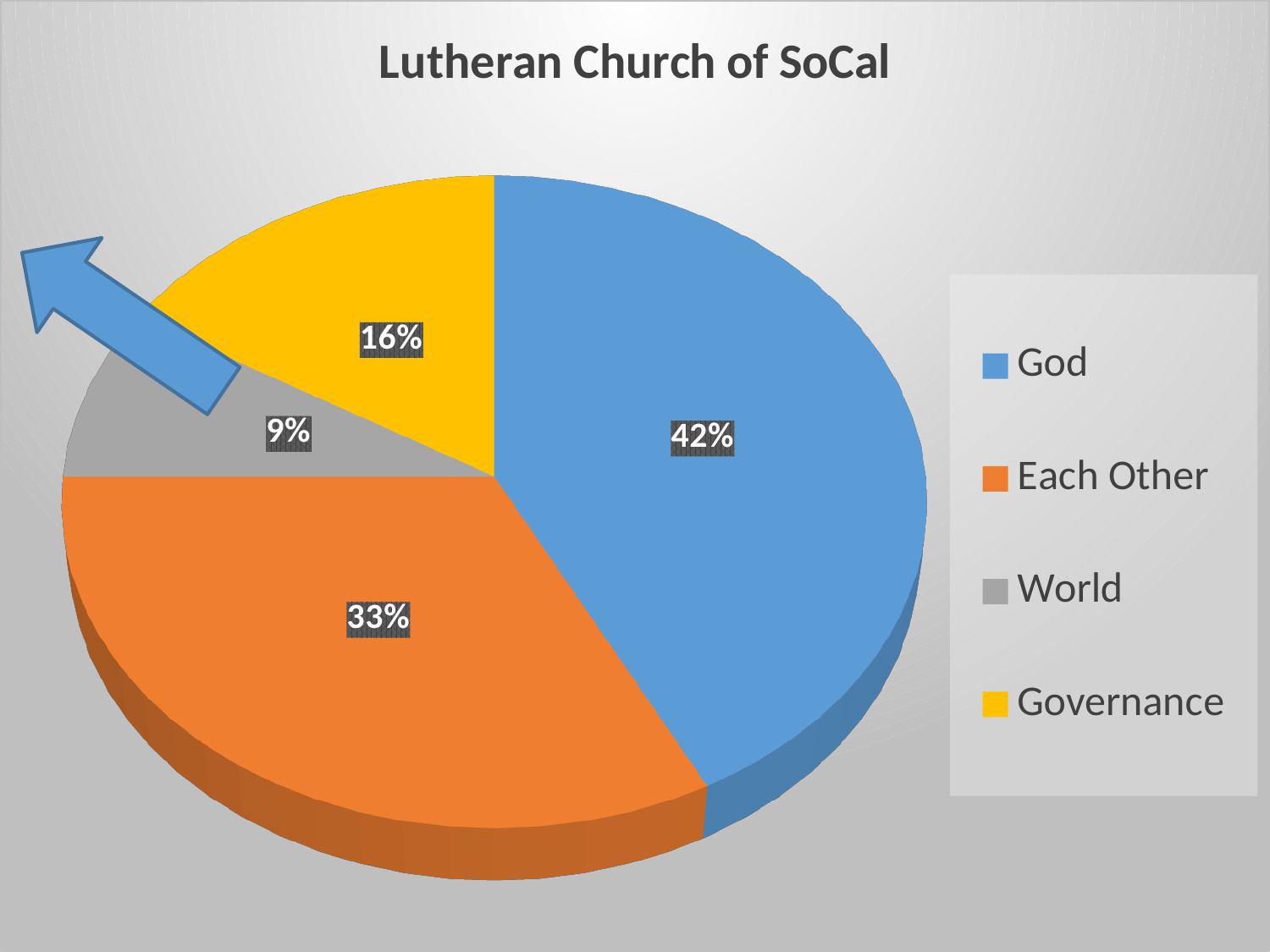
What is the difference in percentage points between the God slice and the Each Other slice? 9 How many categories does the legend list? 4 Which category has the largest share of the pie? God What percentage of the pie is the God slice? 42% What percentage of the pie is the Each Other slice? 33% What is the title of the chart? Lutheran Church of SoCal What colour is the Governance slice? yellow What kind of chart is shown on the slide? pie chart Which category has the smallest share of the pie? World What percentage of the pie is the Governance slice? 16% What percentage of the pie is the World slice? 9% Which is larger, the Governance slice or the World slice? Governance